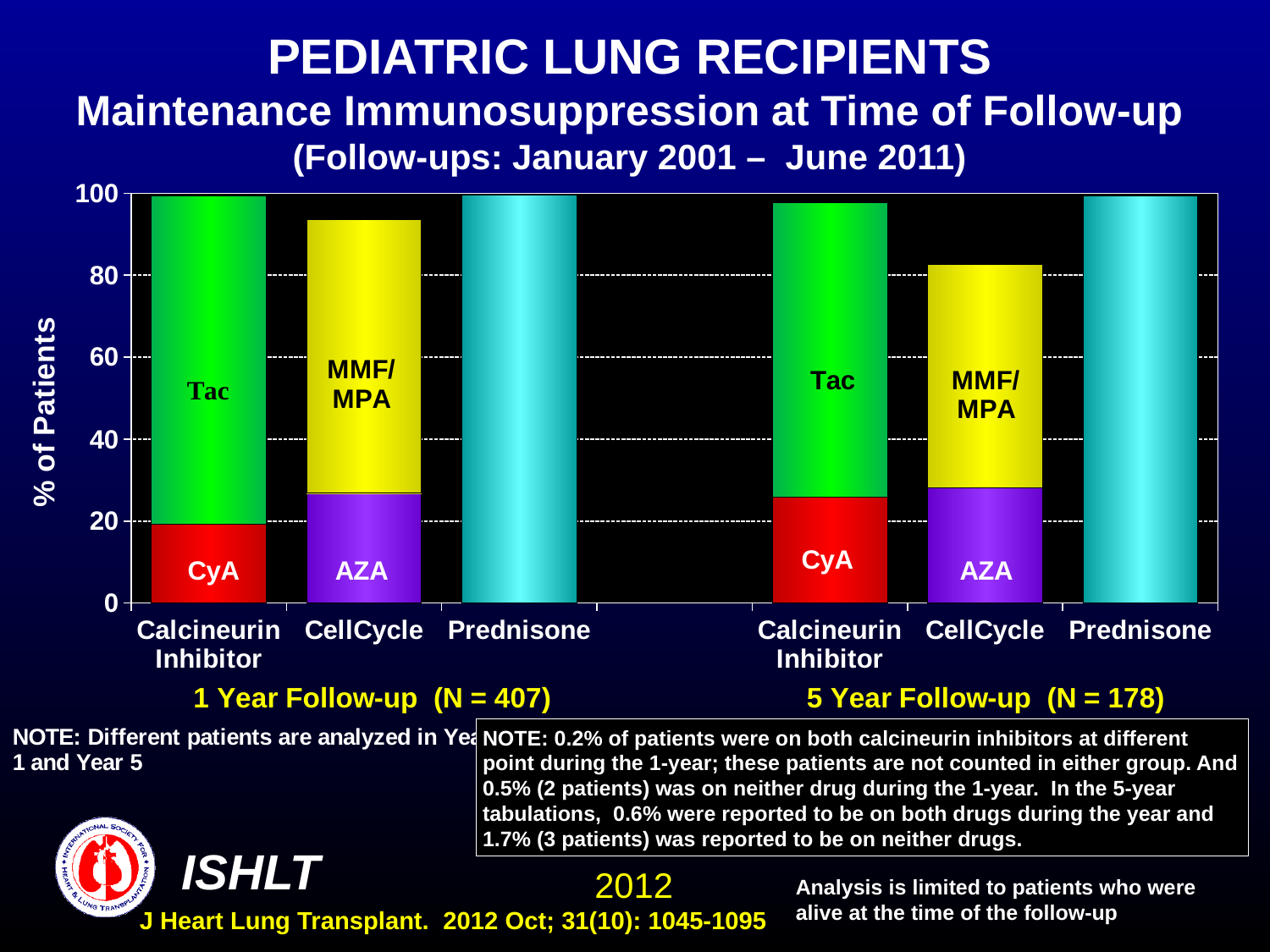
In the 1 Year Follow-up group, is the value for AZA greater or less than 20? greater In the 5 Year Follow-up group, is the value for Prednisone greater or less than 80? greater What kind of chart is shown on the slide? bar chart How many categories are shown on the x axis for the 1 Year Follow-up group? 3 What is the N for the 5 Year Follow-up group? 178 Which is larger: the total CellCycle bar at 1 Year Follow-up or at 5 Year Follow-up? 1 Year Follow-up In the 5 Year Follow-up group, is the top of the CellCycle stacked bar greater or less than 100? less What is the label on the y axis of the chart? % of Patients How many bars are plotted in total across both follow-up groups? 6 Which is larger: the CyA segment at 1 Year Follow-up or at 5 Year Follow-up? 5 Year Follow-up